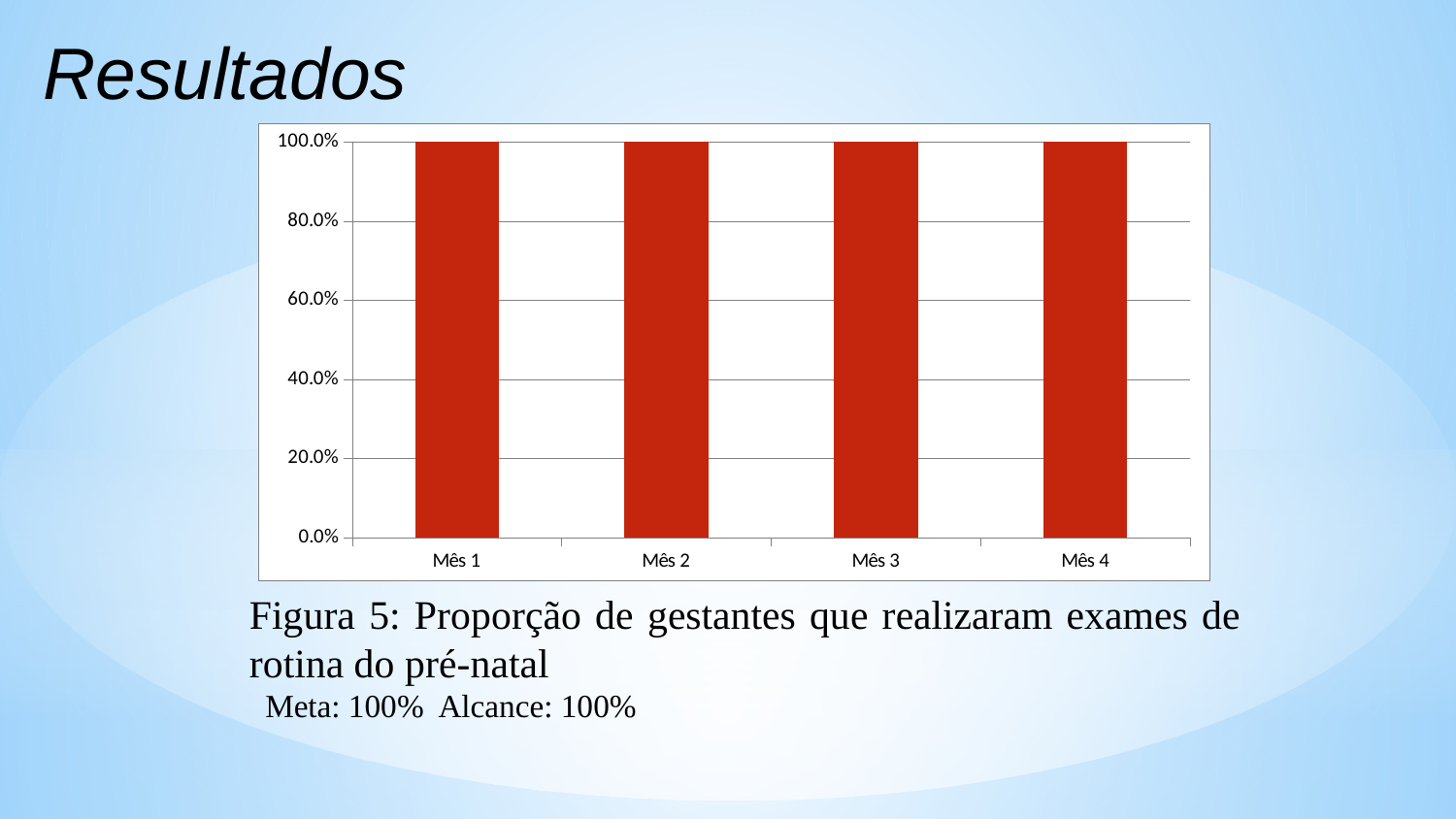
What is the value for Mês 3 in the chart? 100.0% What kind of chart is shown on the slide? bar chart How many categories (months) are shown on the x axis of the chart? 4 Do the values rise, fall, or stay the same from Mês 1 to Mês 4? stay the same What is the difference between the values for Mês 1 and Mês 4? 0.0% What is the highest value shown on the y axis of the chart? 100.0% What is the value for Mês 1 in the chart? 100.0% What is the label of the first category on the x axis? Mês 1 Is the value for Mês 2 greater or less than 80.0%? greater What is the value for Mês 4 in the chart? 100.0%